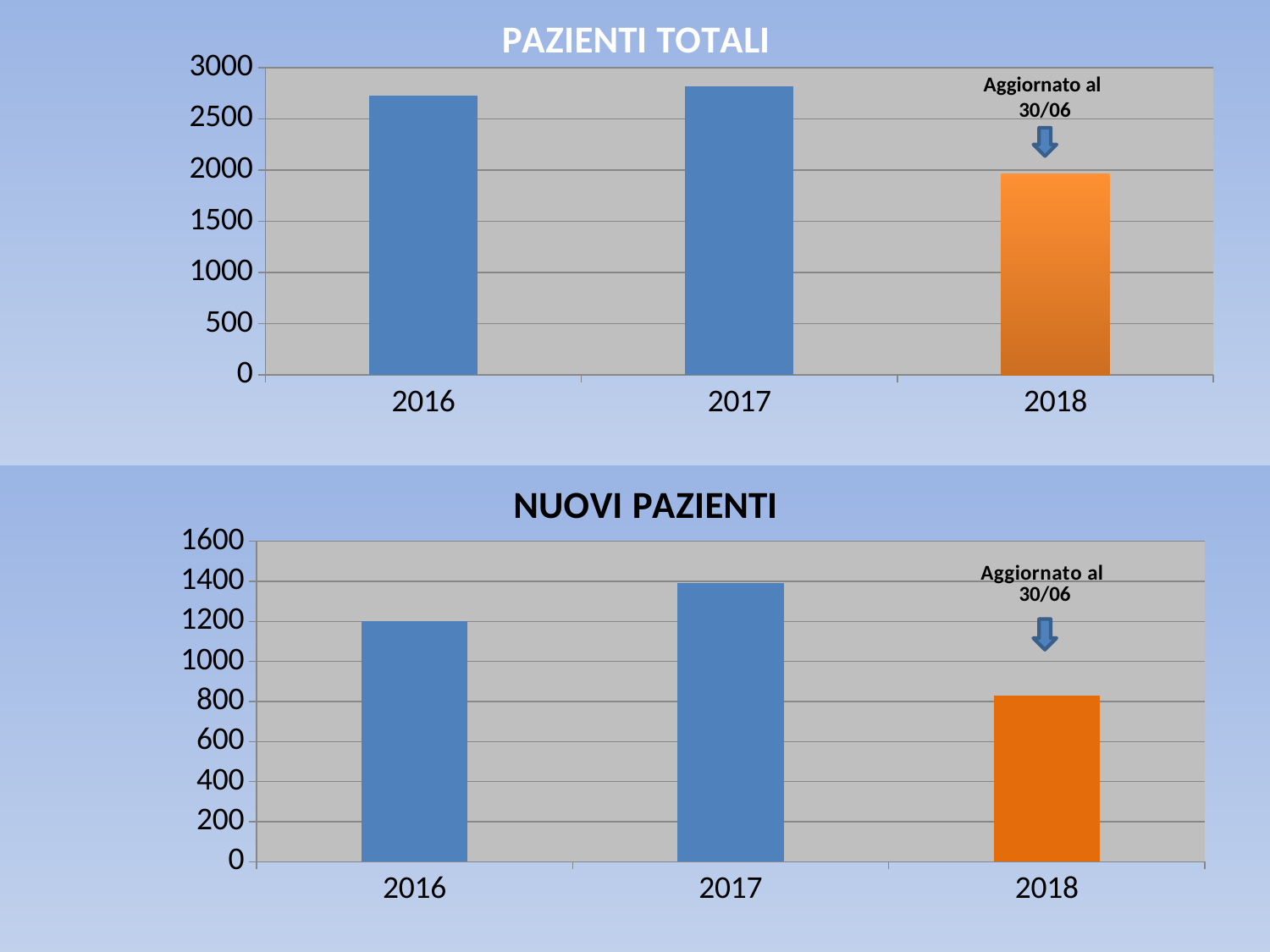
In the PAZIENTI TOTALI chart, is the value for 2018 greater or less than 1500? greater In the PAZIENTI TOTALI chart, which year has the lowest value? 2018 In the NUOVI PAZIENTI chart, which year has the highest value? 2017 In the NUOVI PAZIENTI chart, which year has the lowest value? 2018 In the PAZIENTI TOTALI chart, what kind of chart is shown? bar chart In the NUOVI PAZIENTI chart, is the value for 2018 greater or less than 1000? less In the PAZIENTI TOTALI chart, is the value for 2016 greater or less than 2500? greater In the PAZIENTI TOTALI chart, which is larger, the value for 2017 or the value for 2018? 2017 In the NUOVI PAZIENTI chart, how many years are plotted? 3 In the NUOVI PAZIENTI chart, which is larger, the value for 2016 or the value for 2018? 2016 In the NUOVI PAZIENTI chart, what annotation appears above the 2018 bar? Aggiornato al 30/06